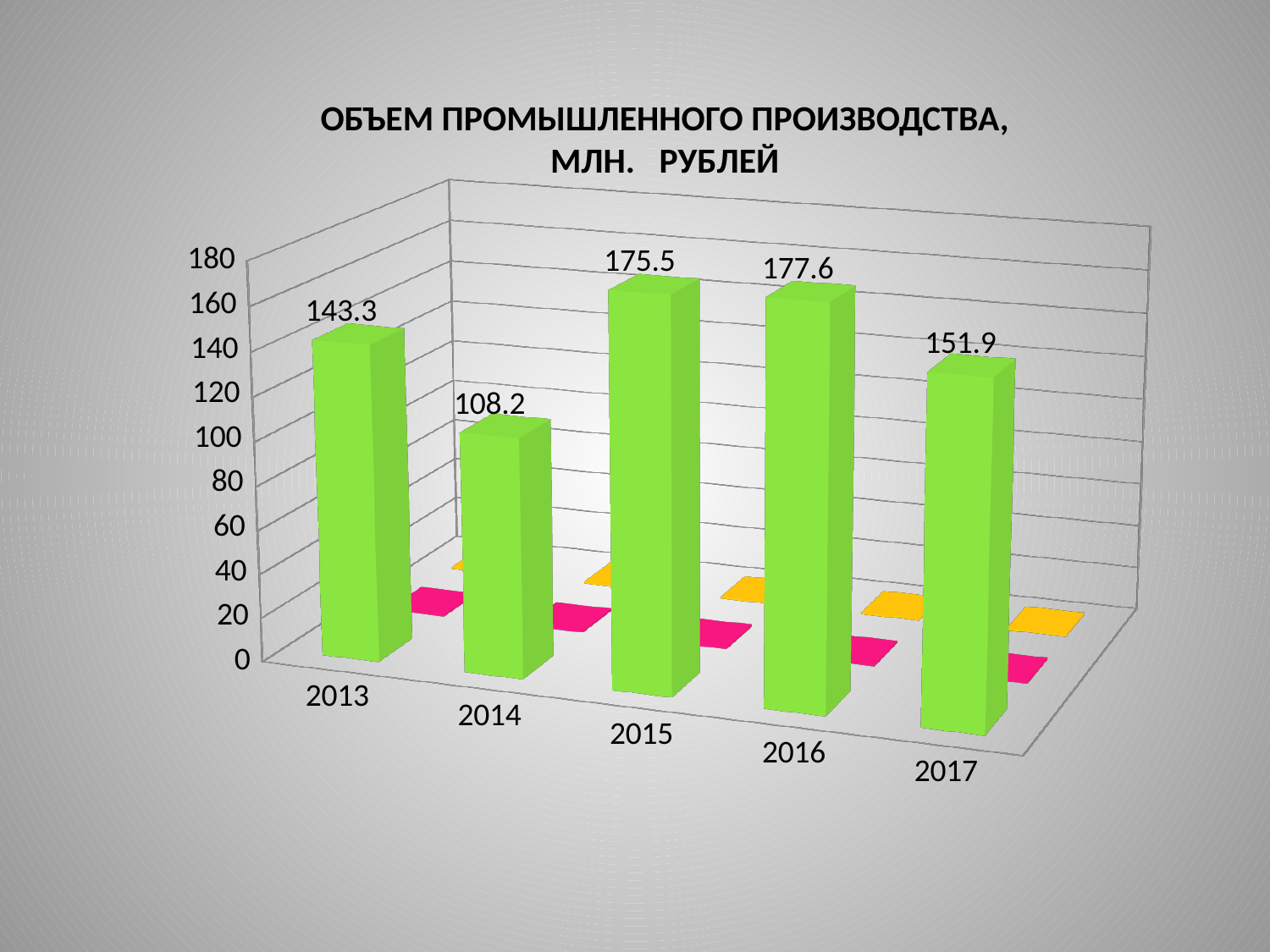
Which is larger, the value for 2013 or the value for 2017? 2017 From 2014 to 2016, do the values rise or fall? rise Which year has the highest value? 2016 What is the difference between the values for 2016 and 2015? 2.1 What is the value for 2013? 143.3 What is the difference between the values for 2013 and 2014? 35.1 What is the value for 2014? 108.2 What kind of chart is shown on the slide? bar chart Is the value for 2014 greater or less than 120? less Which year has the lowest value? 2014 How many years are shown on the x axis? 5 What is the value for 2017? 151.9